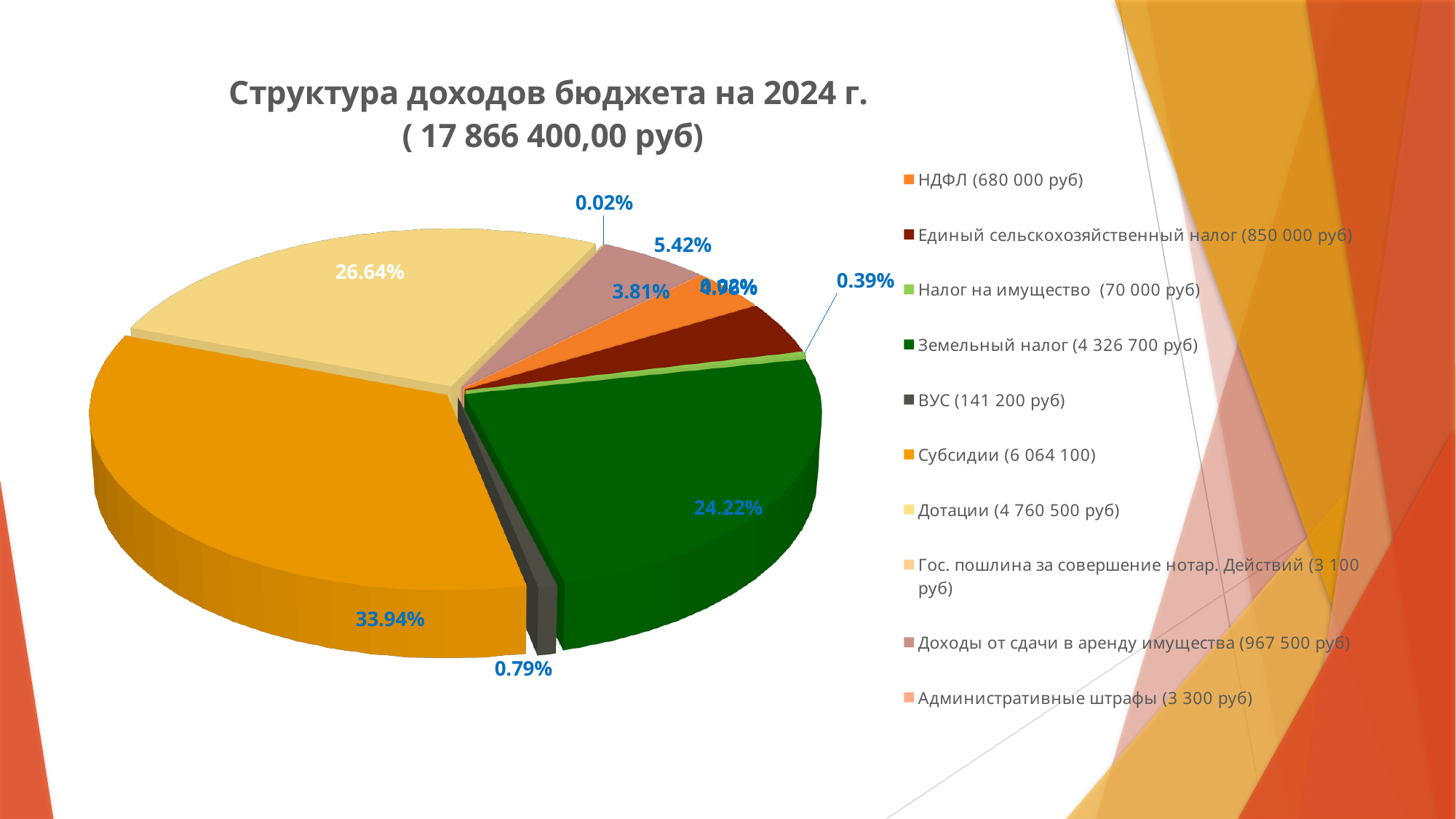
What kind of chart is shown on the slide? pie chart Which is larger, the slice for Дотации or the slice for Земельный налог? Дотации What share of the pie does НДФЛ have? 3.81% What share of the pie does Дотации have? 26.64% Which category has the largest slice of the pie? Субсидии What is the difference in percentage points between the Субсидии slice and the Дотации slice? 7.30% How many entries does the chart legend list? 10 What is the title of the chart? Структура доходов бюджета на 2024 г. ( 17 866 400,00 руб) What share of the pie does ВУС have? 0.79%